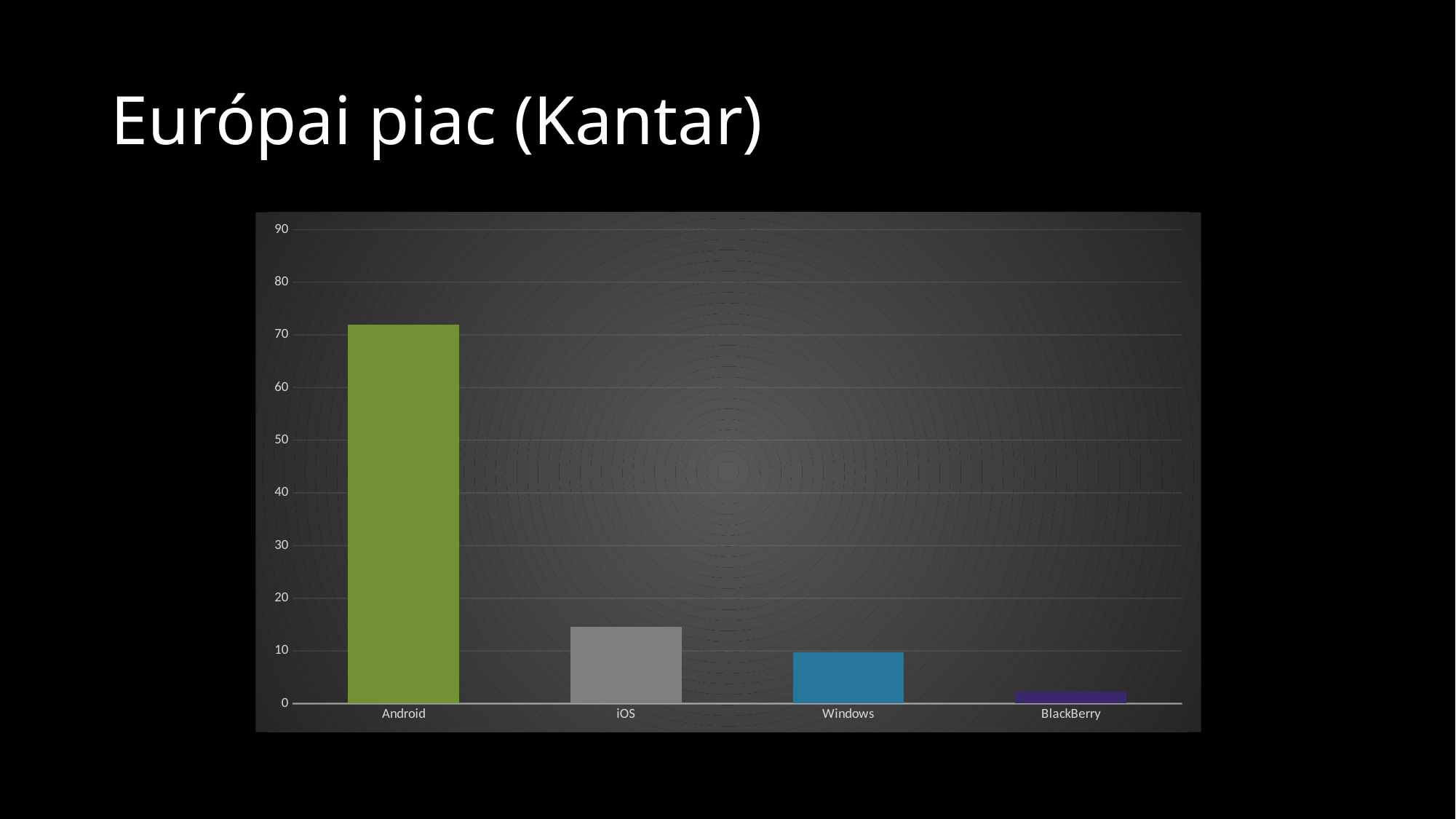
Which is larger, the value for iOS or the value for Windows? iOS Is the value for BlackBerry greater or less than 10? less What is the title of the slide containing the chart? Európai piac (Kantar) Is the value for iOS greater or less than 10? greater What kind of chart is shown on the slide? bar chart Is the value for Android greater or less than 70? greater Which category has the lowest bar in the chart? BlackBerry How many categories are shown on the x axis of the chart? 4 Which category has the highest bar in the chart? Android